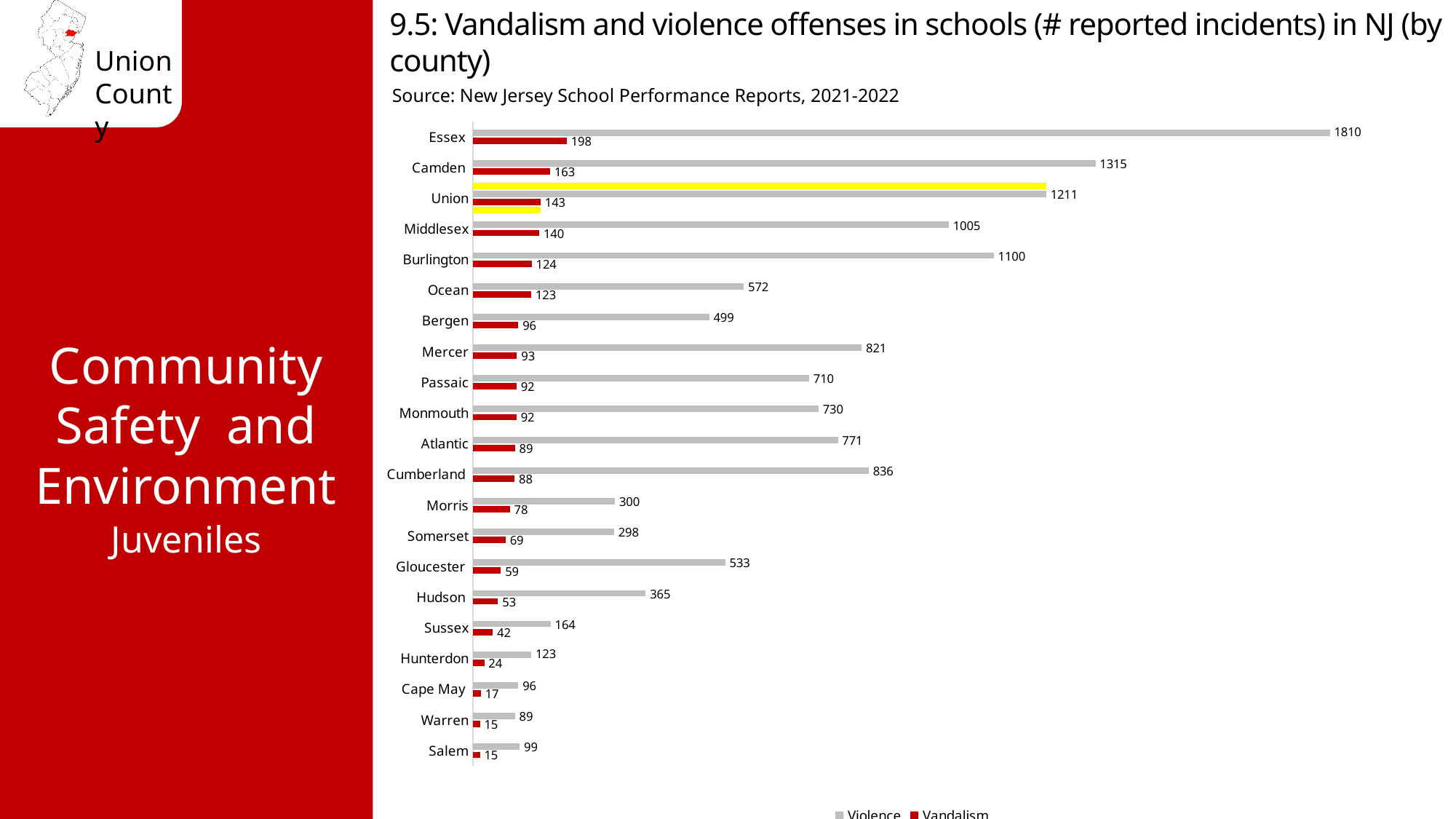
How many reported violence incidents does the chart show for Essex? 1810 Which has a higher vandalism value, Morris or Somerset? Morris Which county has the highest number of violence incidents? Essex Which has a higher violence value, Burlington or Middlesex? Burlington What is the violence value shown for Burlington? 1100 What is the difference between the vandalism values for Union and Middlesex? 3 Which county has the lowest number of violence incidents? Warren What is the difference between the violence values for Essex and Camden? 495 How many series does the legend list? 2 What type of chart is shown on the slide? Bar chart How many counties are shown on the chart? 21 What is the vandalism value shown for Union county? 143